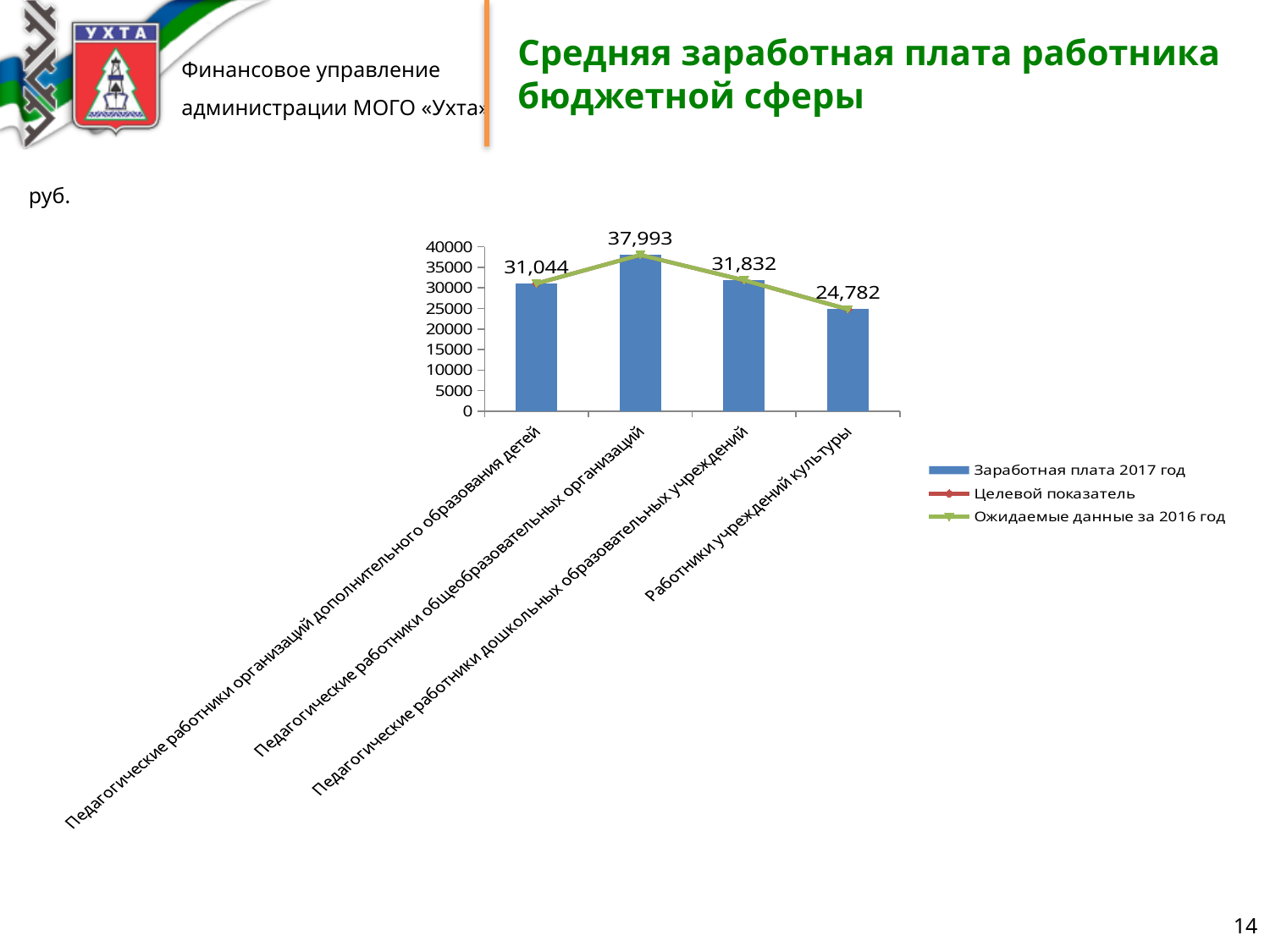
How many categories are shown on the x axis of the chart? 4 Is the value for 'Работники учреждений культуры' greater or less than 30000? less Which category has the lowest labelled value? Работники учреждений культуры How many series does the chart legend list? 3 Which labelled value is larger: 'Педагогические работники дошкольных образовательных учреждений' or 'Педагогические работники организаций дополнительного образования детей'? Педагогические работники дошкольных образовательных учреждений Which category has the highest labelled value? Педагогические работники общеобразовательных организаций What is the difference between the labelled values for 'Педагогические работники общеобразовательных организаций' and 'Работники учреждений культуры'? 13,211 What unit is indicated for the values in the chart? руб. What is the data label shown for the category 'Работники учреждений культуры'? 24,782 What is the data label shown for the category 'Педагогические работники дошкольных образовательных учреждений'? 31,832 What is the data label shown for the category 'Педагогические работники общеобразовательных организаций'? 37,993 What is the data label shown for the category 'Педагогические работники организаций дополнительного образования детей'? 31,044